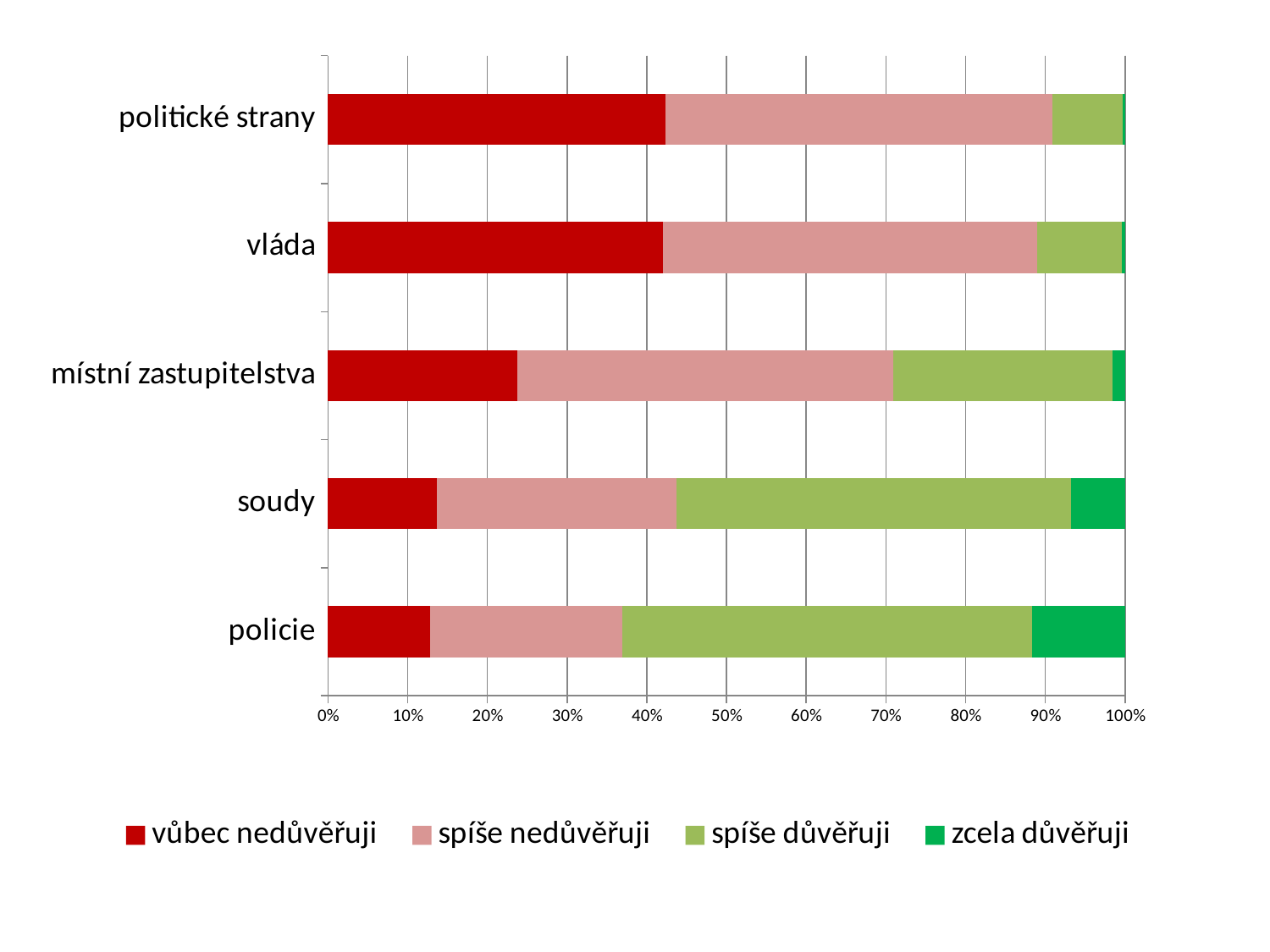
Which category is listed at the top of the chart? politické strany Which has the larger 'vůbec nedůvěřuji' value, 'vláda' or 'soudy'? vláda What does each stacked bar total on the horizontal axis? 100% Which category has the smallest 'spíše nedůvěřuji' segment? policie Is the 'vůbec nedůvěřuji' value for 'místní zastupitelstva' greater or less than 20%? greater What kind of chart is shown on the slide? bar chart Is the 'vůbec nedůvěřuji' value for 'politické strany' greater or less than 40%? greater How many categories are shown on the vertical axis of the chart? 5 Is the 'vůbec nedůvěřuji' value for 'policie' greater or less than 20%? less Which category has the largest 'zcela důvěřuji' segment? policie How many series does the legend list? 4